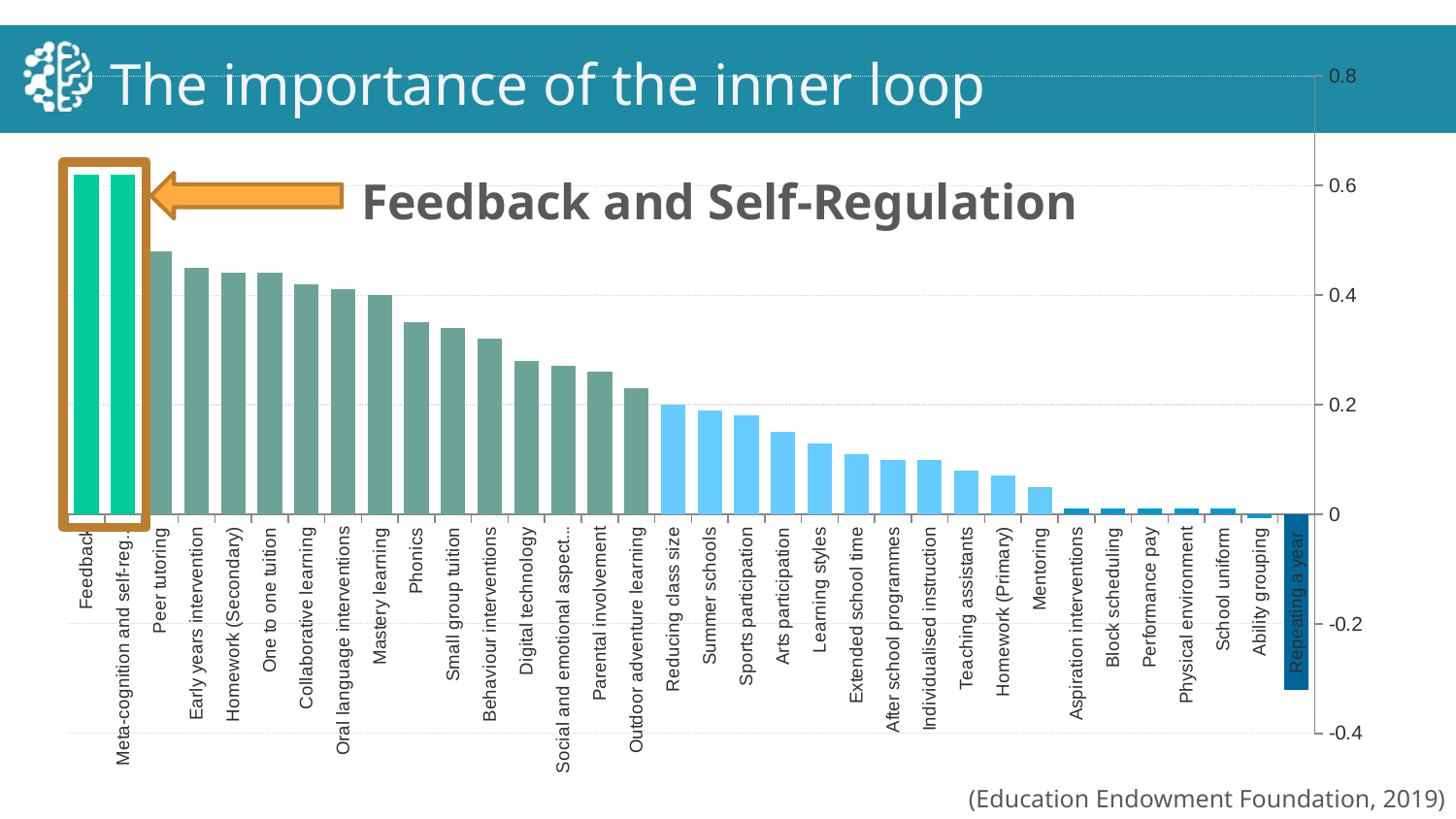
Which has the larger value, Peer tutoring or Mentoring? Peer tutoring Is the value for Repeating a year greater or less than -0.2? less Is the value for Peer tutoring greater or less than 0.4? greater Is the value for Mentoring greater or less than 0.2? less Which has the larger value, Reducing class size or Digital technology? Digital technology Which category has the lowest value in the chart? Repeating a year Do the bar values rise or fall moving from left to right along the x axis? fall Which two categories does the orange arrow labelled 'Feedback and Self-Regulation' point to? Feedback and Meta-cognition and self-reg... What kind of chart is shown on the slide? bar chart How many categories are plotted in the chart? 34